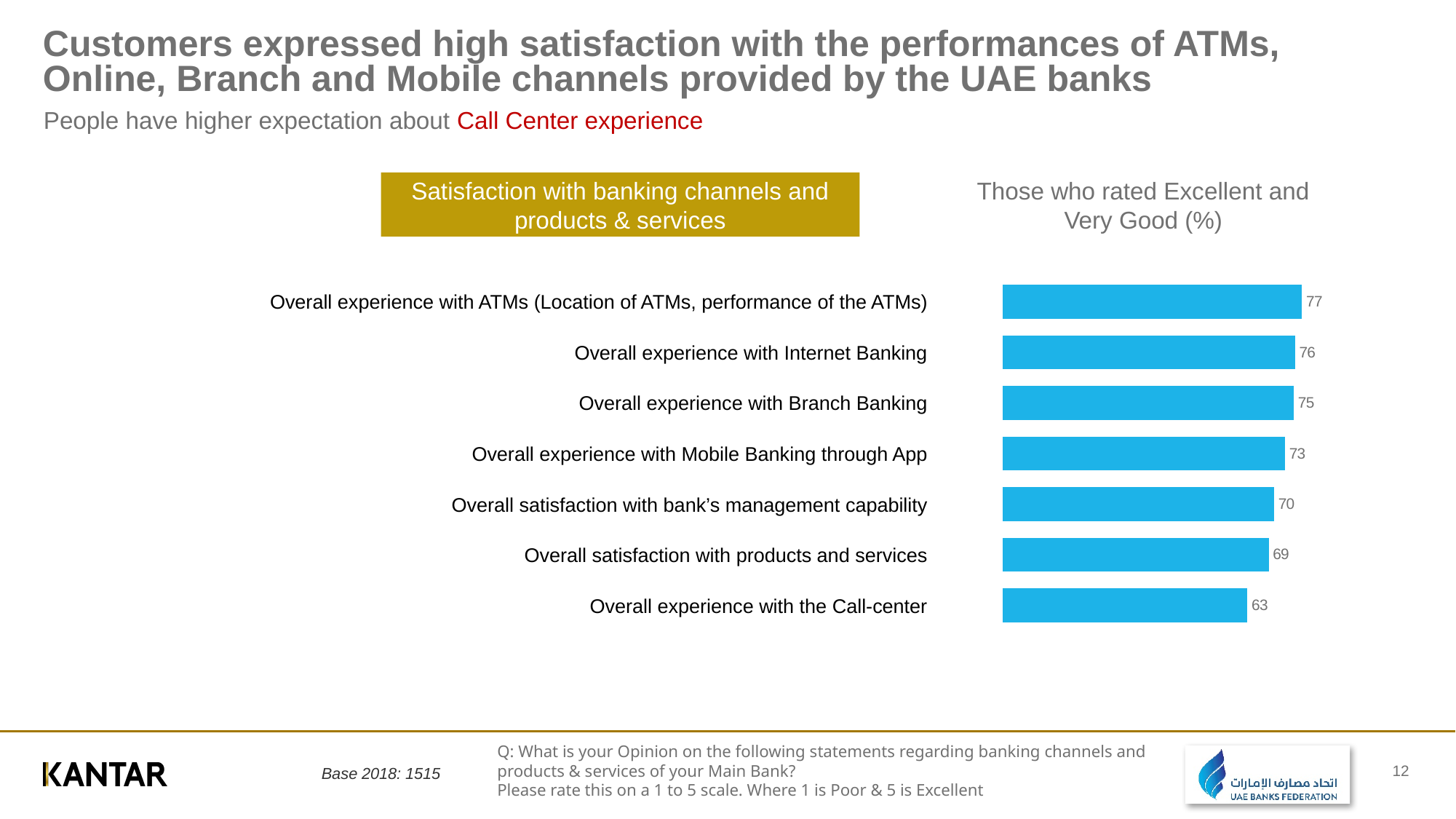
What is the difference between the values for Overall experience with ATMs and Overall experience with the Call-center? 14 What is the value shown for Overall experience with the Call-center? 63 What is the value for Overall satisfaction with products and services? 69 What kind of chart is shown on the slide? Bar chart What is the difference between the values for Overall experience with Internet Banking and Overall satisfaction with bank's management capability? 6 What is the value for Overall experience with Mobile Banking through App? 73 What percentage rated the overall experience with ATMs as Excellent or Very Good? 77 Which is larger: the value for Overall experience with Branch Banking or the value for Overall satisfaction with products and services? Overall experience with Branch Banking Which category has the highest value in the chart? Overall experience with ATMs (Location of ATMs, performance of the ATMs) Which category has the lowest value in the chart? Overall experience with the Call-center What does the column header above the bars say the values represent? Those who rated Excellent and Very Good (%) How many categories are shown in the chart? 7